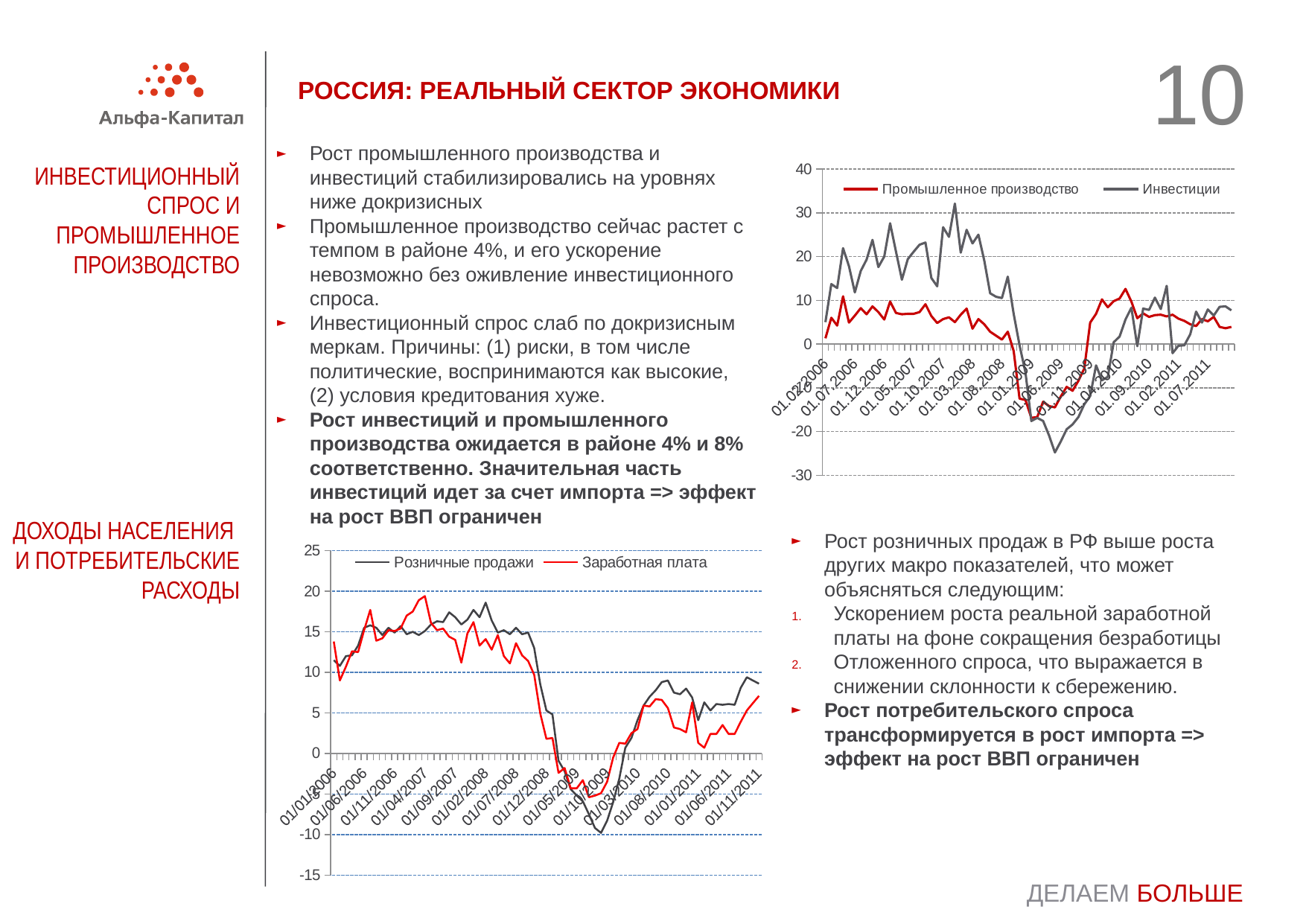
What kind of chart is the chart in the bottom left of the slide? line chart In the top-right chart, is the lowest value reached by Инвестиции greater or less than -20? less In the top-right chart, which series reaches the lower minimum, Промышленное производство or Инвестиции? Инвестиции How many series does the legend of the bottom-left chart list? 2 In the top-right chart, which series is drawn in red? Промышленное производство In the top-right chart, is the highest value reached by Инвестиции greater or less than 20? greater How many series does the legend of the top-right chart list? 2 In the bottom-left chart, which series is drawn in red? Заработная плата What kind of chart is the chart in the top right of the slide? line chart In the bottom-left chart, do the values of Розничные продажи rise or fall between 01/07/2008 and 01/10/2009? fall In the bottom-left chart, is the value of Розничные продажи at 01/11/2011 greater or less than 5? greater In the top-right chart, which series reaches the higher maximum, Промышленное производство or Инвестиции? Инвестиции